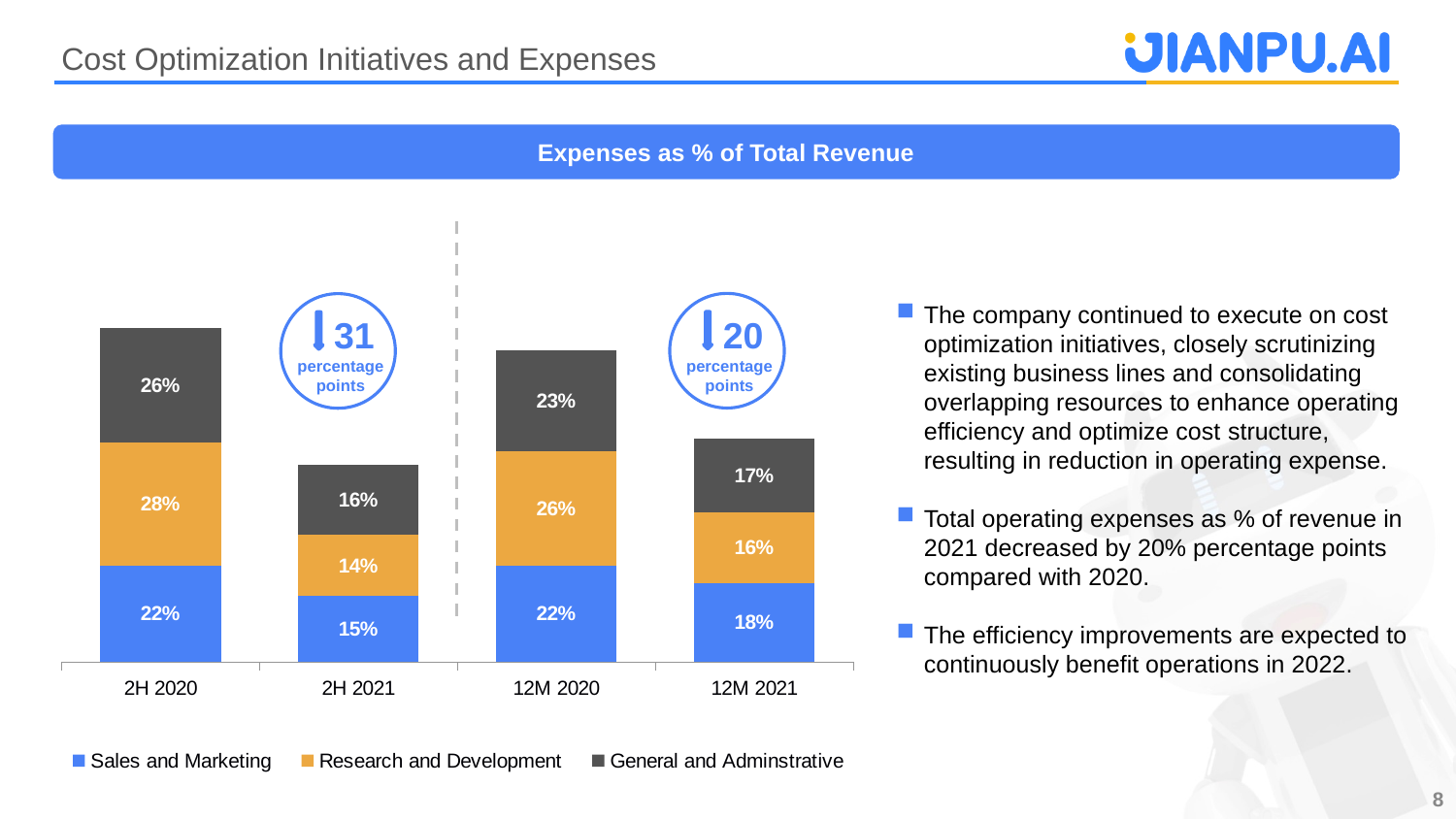
Which category has the lowest Sales and Marketing value? 2H 2021 What is the total of the stacked bar for 12M 2021? 51% What is the General and Adminstrative value for 2H 2021? 16% What is the total of the stacked bar for 2H 2020? 76% What is the Sales and Marketing value for 2H 2020? 22% How many categories are shown on the x axis? 4 How many series does the legend list? 3 Which is larger, the Research and Development value for 2H 2021 or for 12M 2021? 12M 2021 What is the difference between the General and Adminstrative values for 12M 2020 and 12M 2021? 6 percentage points What kind of chart is shown on the slide? Stacked bar chart What is the Research and Development value for 12M 2021? 16% Which category has the highest Research and Development value? 2H 2020